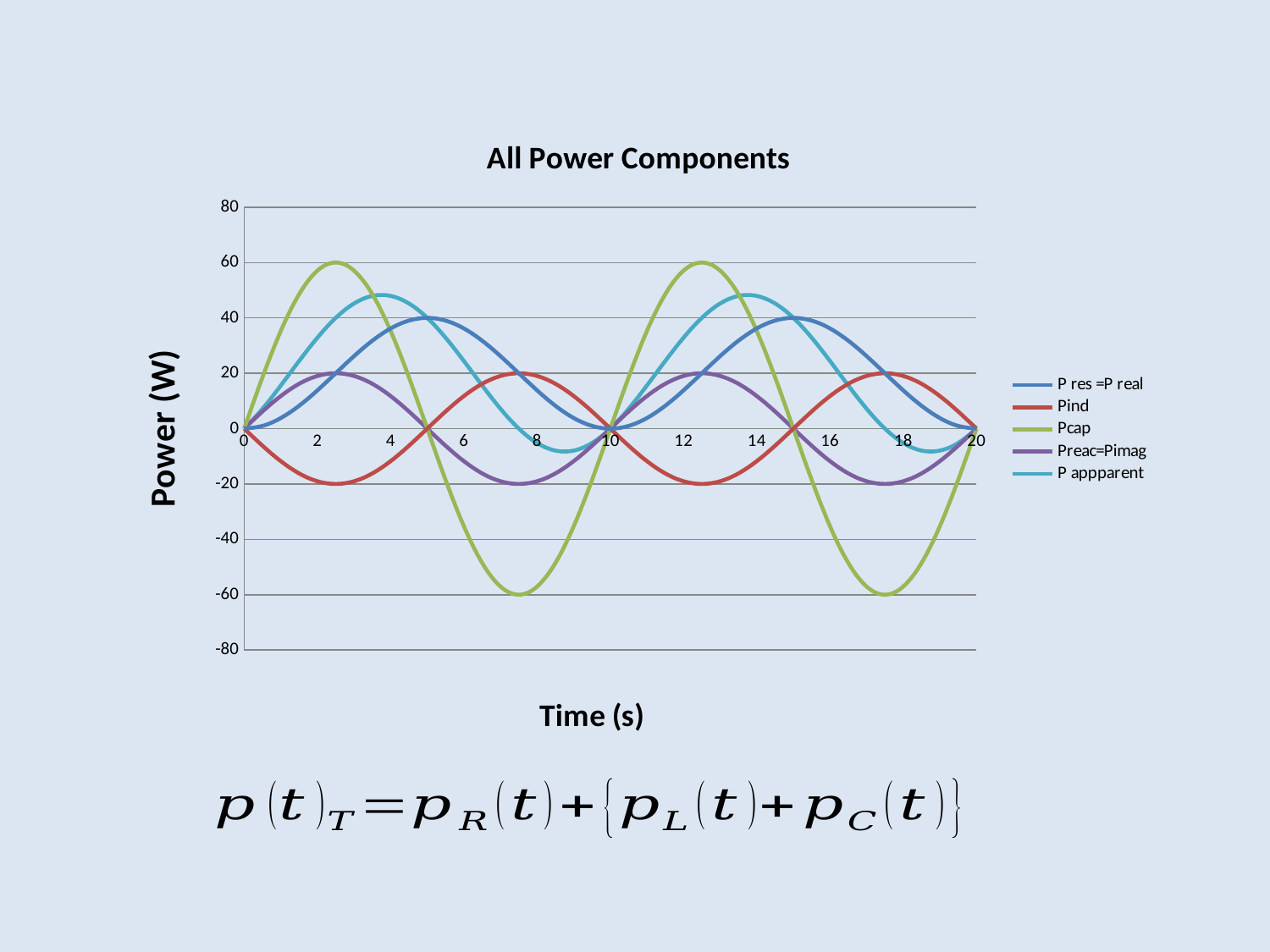
What is the title of the chart? All Power Components What is the minimum value reached by the Pind series? -20 Which series has the higher peak value, P appparent or P res =P real? P appparent What is the peak value reached by the Pcap series? 60 What is the label of the vertical axis? Power (W) Which series reaches the lowest value on the chart? Pcap How many series does the legend list? 5 Is the minimum value of the Pcap series greater or less than -40? less What is the peak value reached by the P res =P real series? 40 Is the peak value of the P appparent series greater or less than 40? greater What kind of chart is shown on the slide? line chart Which series reaches the highest peak value on the chart? Pcap